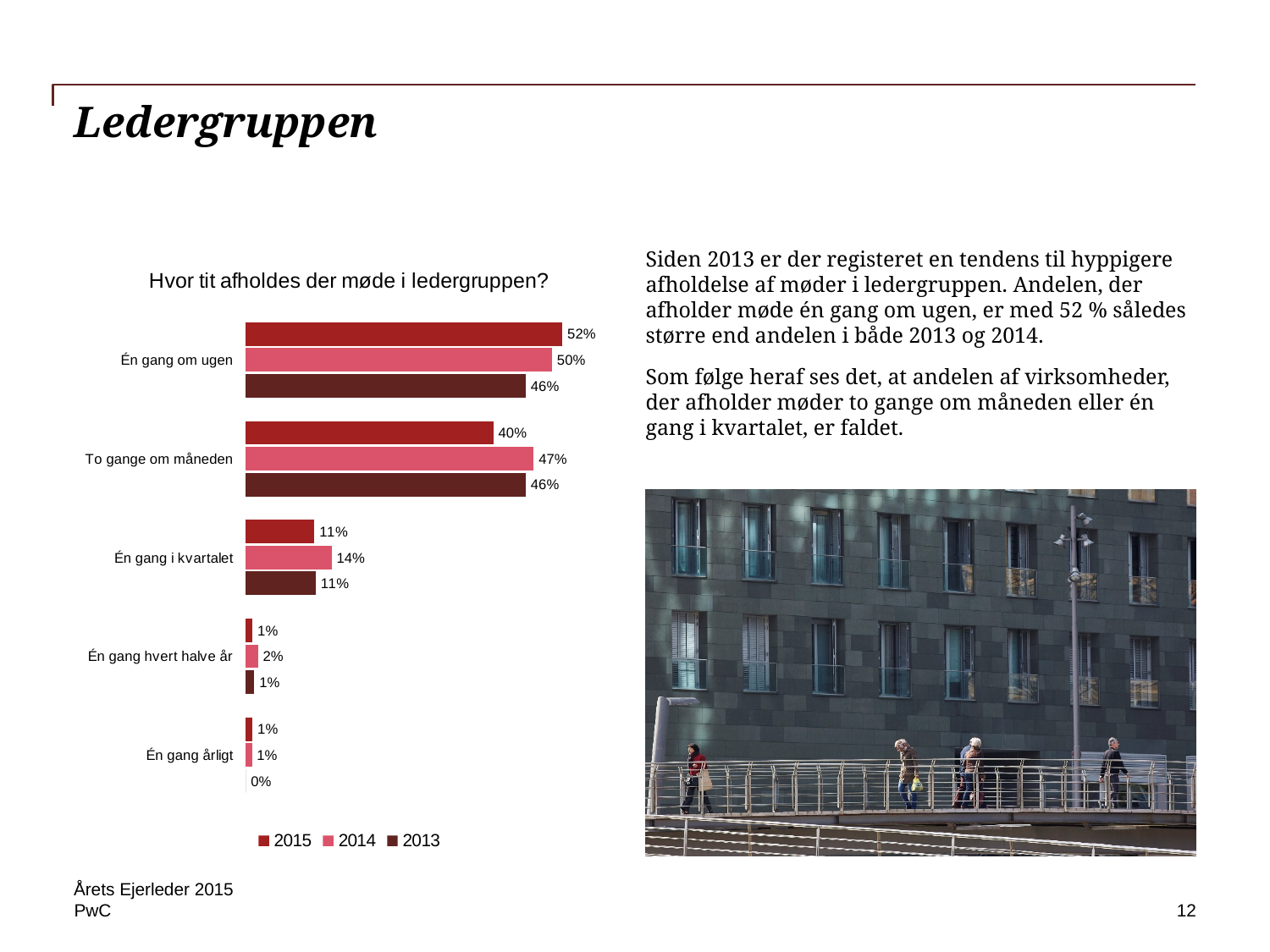
For "To gange om måneden", which is larger: the 2014 value or the 2015 value? 2014 How many series does the legend list? 3 What kind of chart is shown on the slide? Bar chart What is the difference between the 2015 and 2013 values for "Én gang om ugen"? 6% What is the 2015 value for "Én gang om ugen"? 52% What is the 2013 value for "Én gang i kvartalet"? 11% What is the title of the chart? Hvor tit afholdes der møde i ledergruppen? Which category has the lowest 2013 value? Én gang årligt Which category has the highest 2015 value? Én gang om ugen What is the 2013 value for "Én gang årligt"? 0% How many categories are shown on the chart? 5 What is the 2014 value for "To gange om måneden"? 47%